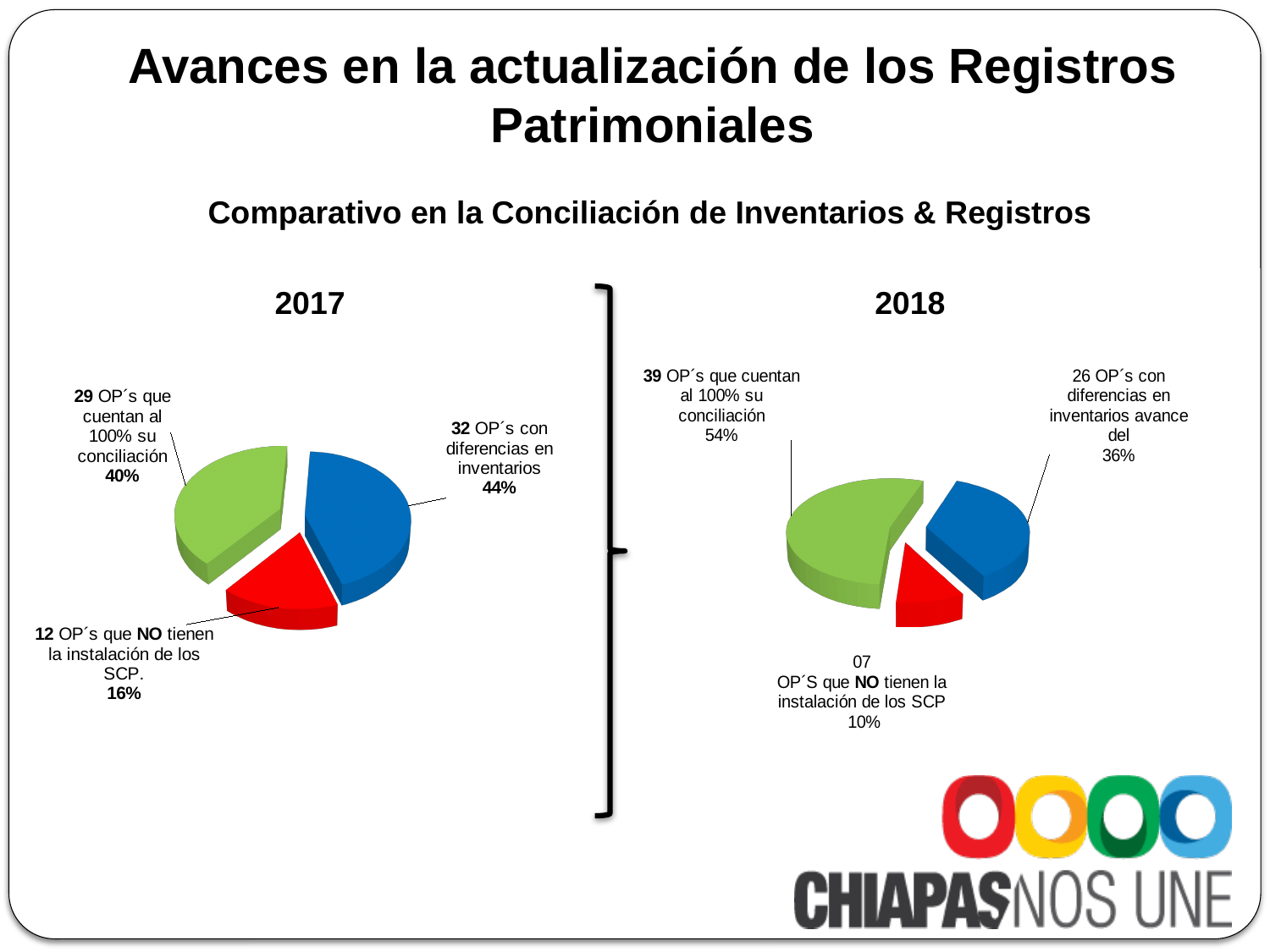
In the 2017 pie chart, what percentage share do the OP's with differences in inventories have? 44% In the 2018 pie chart, how many OP's have differences in inventories? 26 In the 2018 pie chart, what percentage share do the OP's with 100% of their reconciliation have? 54% In the 2017 pie chart, what percentage share do the OP's that do NOT have the SCP installed have? 16% What kind of chart is used for the 2017 data? Pie chart How many slices does the 2018 pie chart have? 3 In the 2017 pie chart, which category has the largest share? 32 OP's con diferencias en inventarios (44%) In the 2018 pie chart, which category has the smallest share? 07 OP'S que NO tienen la instalación de los SCP (10%) What is the difference in the number of OP's with 100% reconciliation between the 2018 chart (39) and the 2017 chart (29)? 10 In the 2018 pie chart, how many OP's do NOT have the SCP installed? 07 In the 2017 pie chart, how many OP's have 100% of their reconciliation? 29 In the 2018 pie chart, which colour is the slice for OP's with 100% of their reconciliation? Green